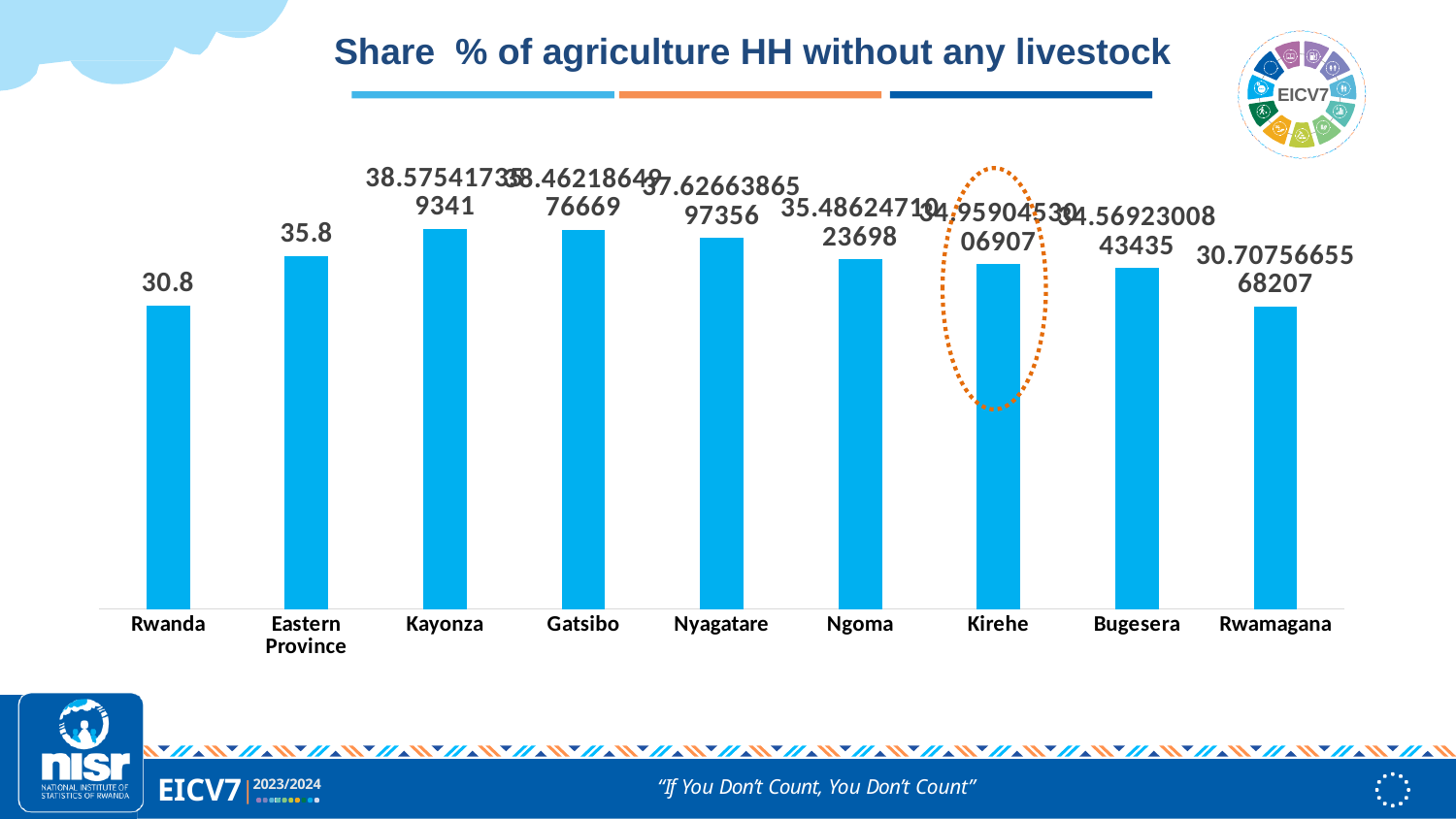
What is the value for Rwanda? 30.8 What is the value for Rwamagana? 30.7075665568207 How many categories are shown on the x axis? 9 Which is larger, the value for Eastern Province or the value for Rwanda? Eastern Province What is the title of the chart? Share % of agriculture HH without any livestock What kind of chart is shown on the slide? Bar chart Which is larger, the value for Bugesera or the value for Rwamagana? Bugesera What is the difference between the values for Eastern Province and Rwanda? 5 What is the value for Eastern Province? 35.8 Which is larger, the value for Nyagatare or the value for Ngoma? Nyagatare Which category's bar is highlighted with a dotted orange circle? Kirehe What is the value for Ngoma? 35.4862471923698